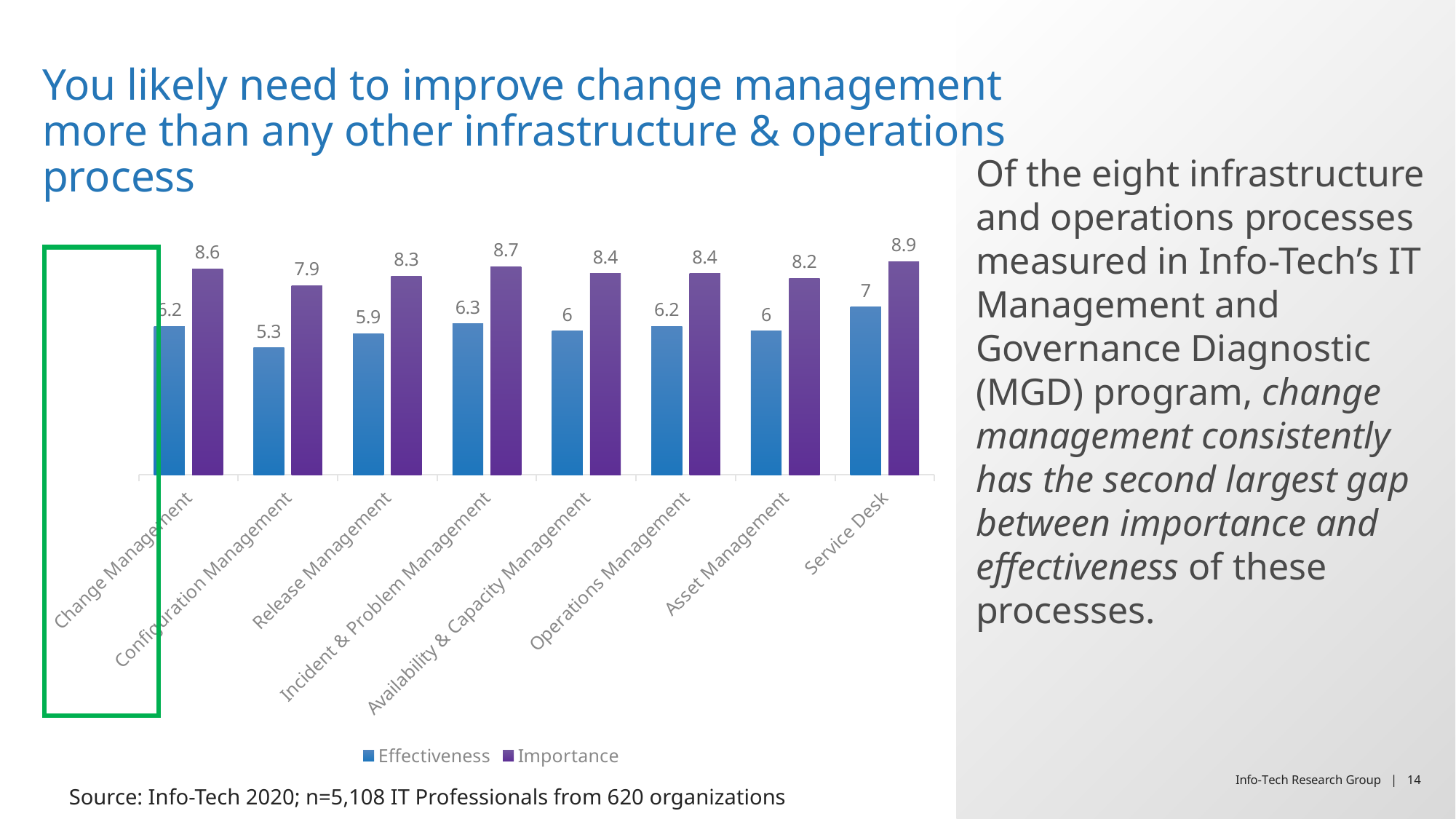
Which has the higher Effectiveness value: Incident & Problem Management or Release Management? Incident & Problem Management What is the Importance value for Asset Management? 8.2 What kind of chart is shown on the slide? Bar chart What is the Importance value for Service Desk? 8.9 How many series does the chart's legend list? 2 Which category has the highest Importance value? Service Desk What is the difference between the Importance and Effectiveness values for Service Desk? 1.9 How many process categories are plotted on the x axis of the chart? 8 What are the two series named in the chart's legend? Effectiveness and Importance What is the Effectiveness value for Configuration Management? 5.3 What is the difference between the Importance and Effectiveness values for Configuration Management? 2.6 Which category has the lowest Effectiveness value? Configuration Management